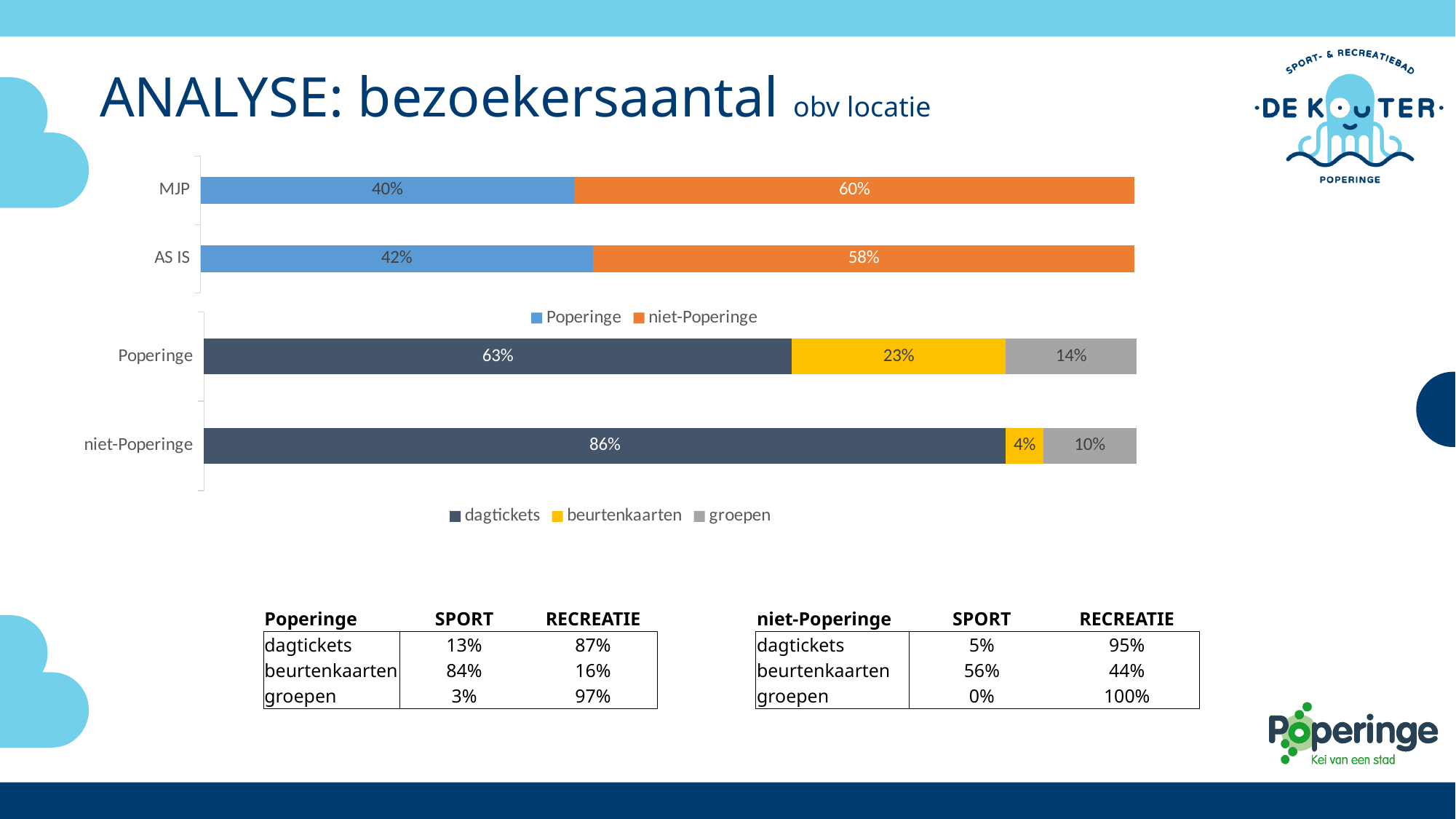
In the bottom chart (Poperinge / niet-Poperinge), how many series does the legend list? 3 In the top chart (MJP / AS IS), what is the difference between the niet-Poperinge share for MJP and the Poperinge share for MJP? 20% In the top chart (MJP / AS IS), which is larger for AS IS: Poperinge or niet-Poperinge? niet-Poperinge What kind of chart is the bottom chart (Poperinge / niet-Poperinge)? Stacked bar chart In the bottom chart (Poperinge / niet-Poperinge), what is the difference between the beurtenkaarten share for Poperinge and for niet-Poperinge? 19% In the bottom chart (Poperinge / niet-Poperinge), what is the beurtenkaarten share for Poperinge? 23% In the bottom chart (Poperinge / niet-Poperinge), what is the dagtickets share for niet-Poperinge? 86% In the top chart (MJP / AS IS), what is the Poperinge share for MJP? 40% In the bottom chart (Poperinge / niet-Poperinge), which category has the highest dagtickets share? niet-Poperinge In the top chart (MJP / AS IS), how many series does the legend list? 2 In the top chart (MJP / AS IS), what is the niet-Poperinge share for AS IS? 58% In the bottom chart (Poperinge / niet-Poperinge), what is the groepen share for niet-Poperinge? 10%